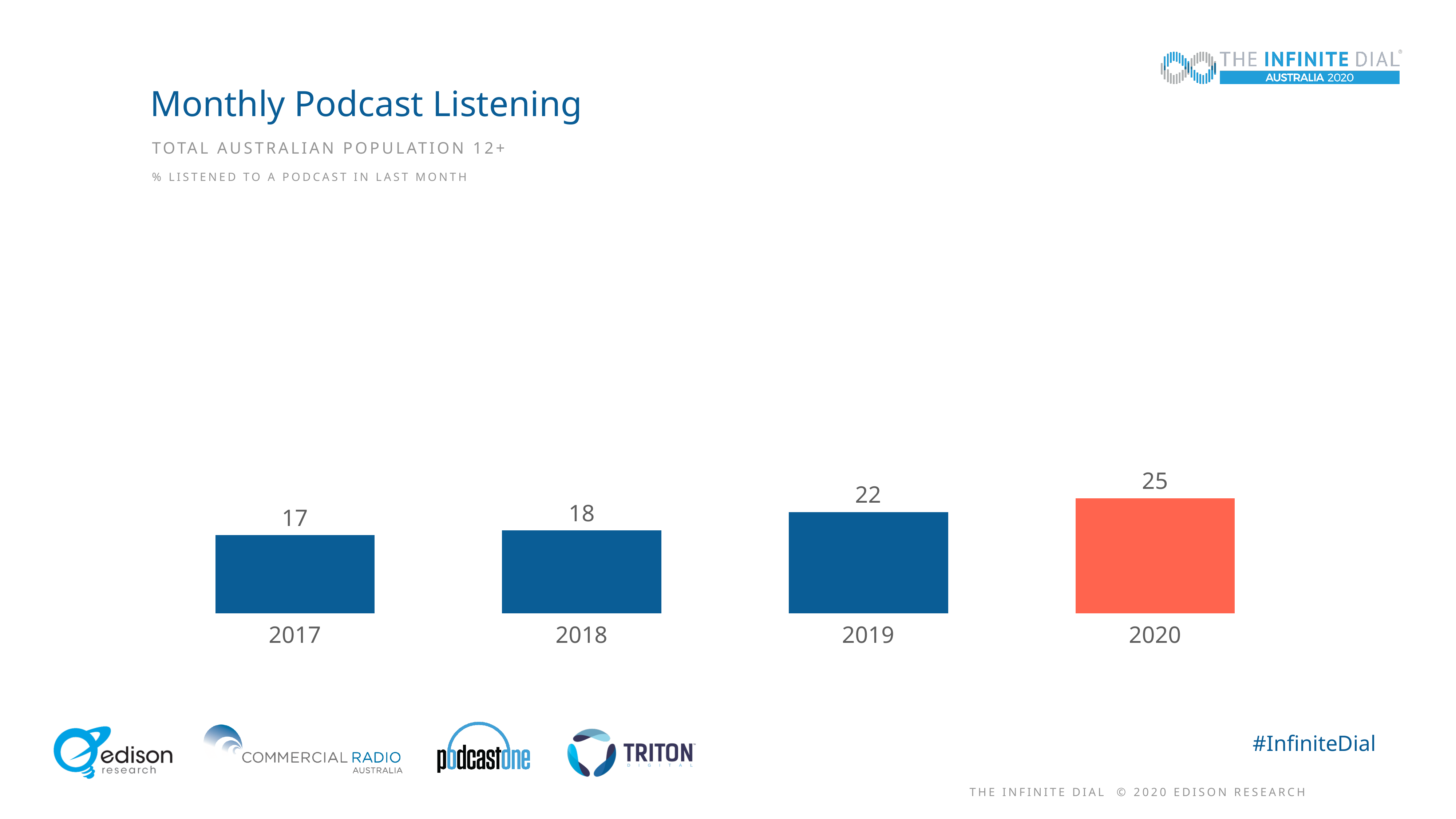
Which year has the highest value? 2020 What is the value for 2019? 22 What kind of chart is shown on the slide? bar chart How many years are shown in the chart? 4 What is the value for 2017? 17 What is the value for 2020? 25 Which is larger, the value for 2019 or the value for 2018? 2019 What is the difference between the values for 2020 and 2017? 8 What is the difference between the values for 2019 and 2018? 4 Do the values rise or fall from 2017 to 2020? rise What is the value for 2018? 18 Which year has the lowest value? 2017